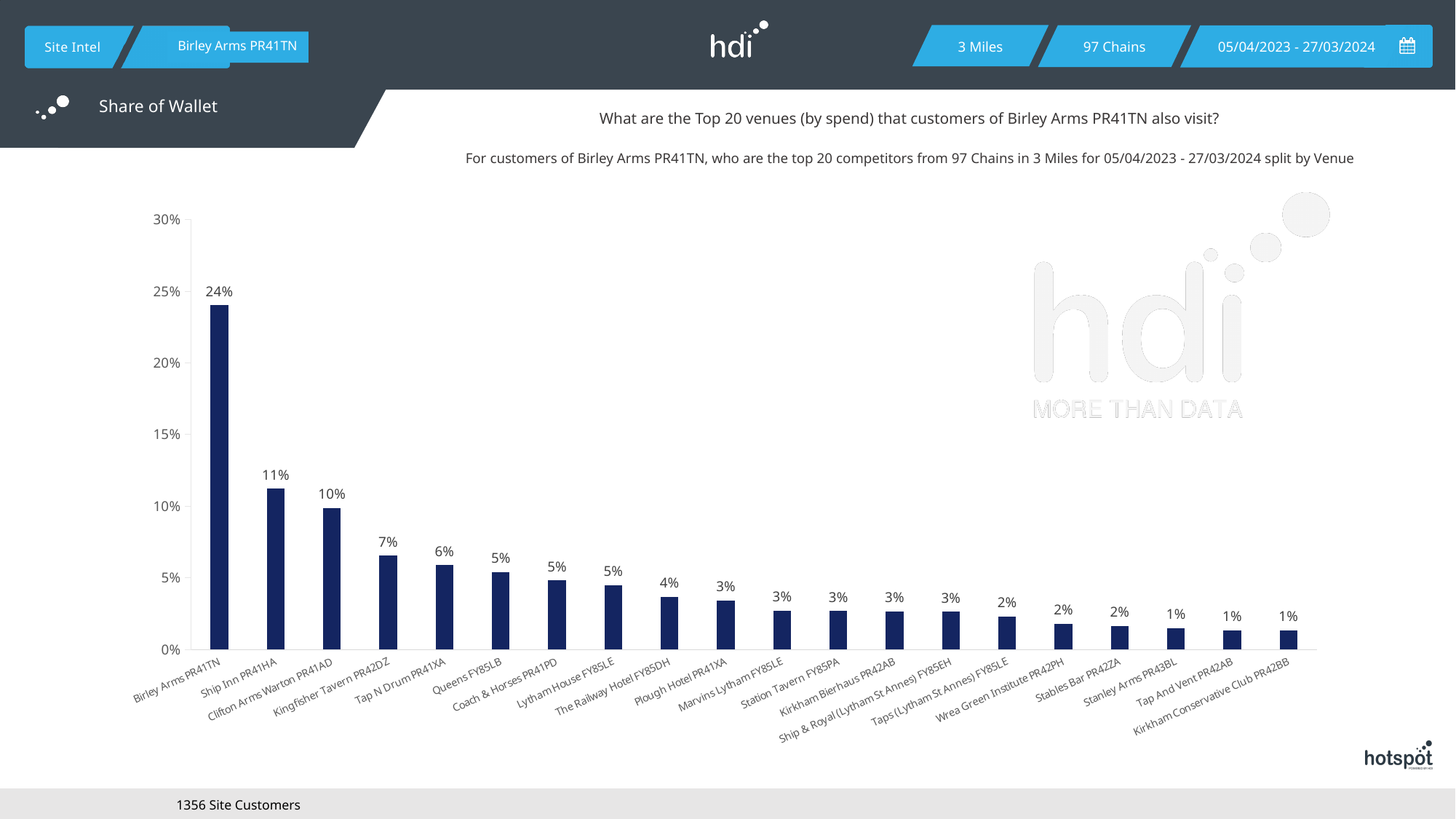
Which is larger, the value for Ship Inn PR41HA or the value for Kingfisher Tavern PR42DZ? Ship Inn PR41HA Is the value for Birley Arms PR41TN greater or less than 20%? greater What is the value for The Railway Hotel FY85DH? 4% Which venue has the highest value? Birley Arms PR41TN How many venues are shown on the chart? 20 What is the value for Birley Arms PR41TN? 24% Do the values rise or fall from left to right along the x axis? fall What kind of chart is shown on the slide? bar chart What is the value for Ship Inn PR41HA? 11% What is the value for Kingfisher Tavern PR42DZ? 7% What is the difference between the values for Clifton Arms Warton PR41AD and Tap N Drum PR41XA? 4% What is the difference between the values for Birley Arms PR41TN and Ship Inn PR41HA? 13%